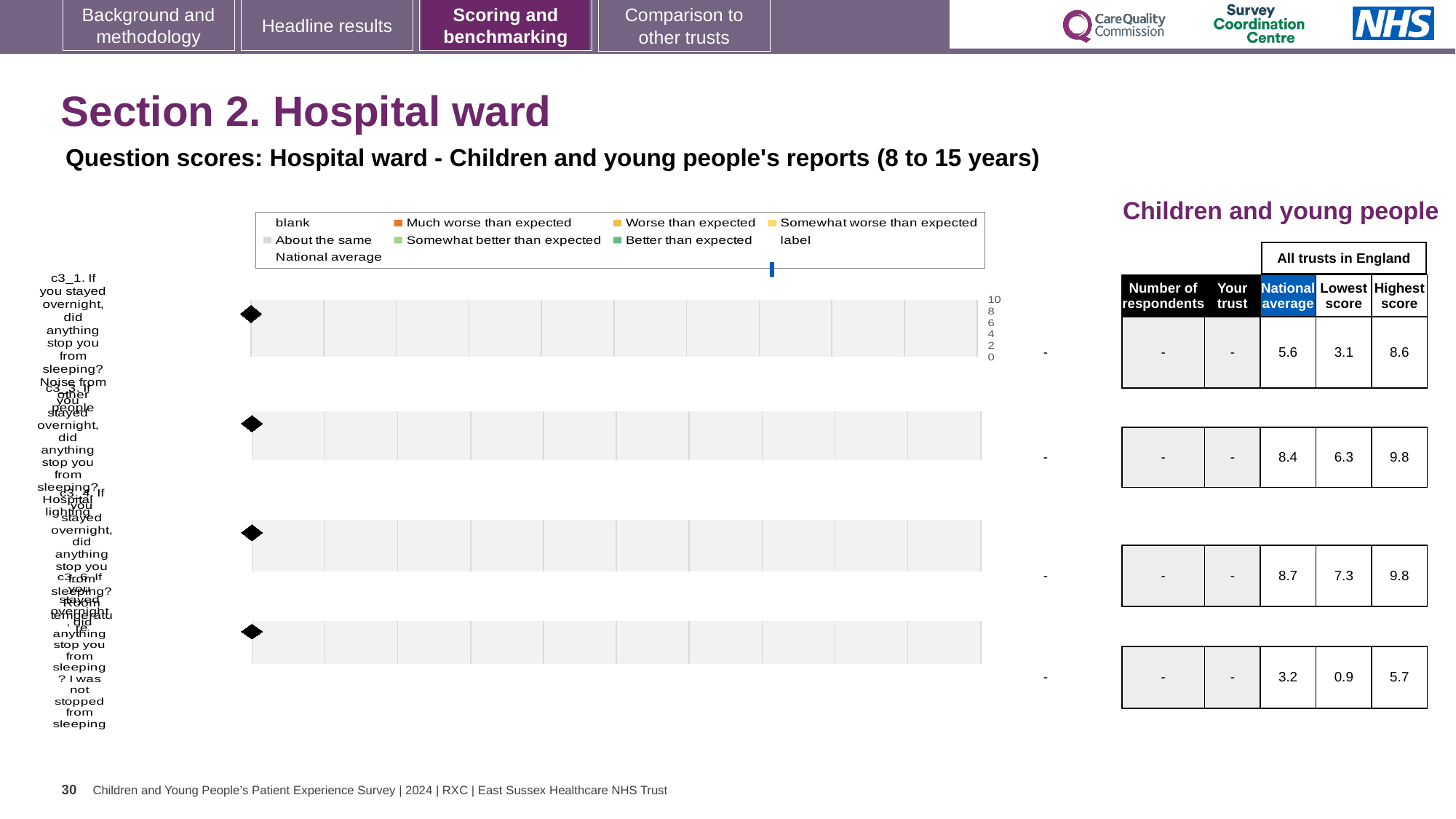
In the table next to the chart, what is the national average for the first row (c3_1)? 5.6 What colour does the legend use for 'Much worse than expected'? orange In the table next to the chart, what is the lowest score for the fourth row (c3_6)? 0.9 What is the question code of the first (top) row in the chart? c3_1 What is the question code of the last (bottom) row in the chart? c3_6 How many question rows (categories) does the chart show? 4 What kind of chart is shown on the slide? bar chart In the table next to the chart, what is the highest score for the second row (c3_3)? 9.8 In the table next to the chart, which row has the highest national average? c3_4 In the table next to the chart, which row has the lowest national average? c3_6 What is the highest value shown on the chart's axis? 10 In the table next to the chart, what is the difference between the highest and lowest score for the first row (c3_1)? 5.5